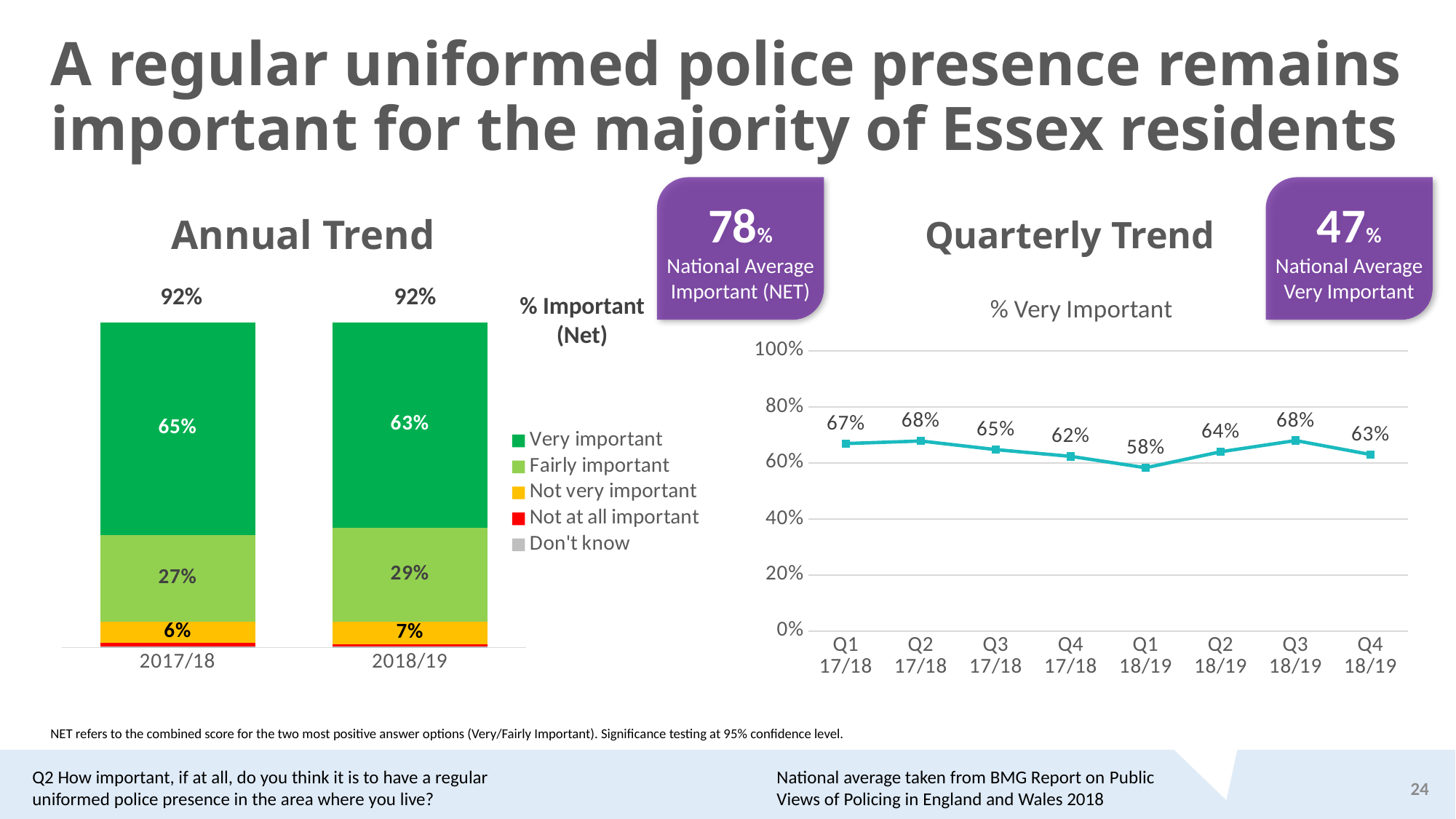
What kind of chart is the Quarterly Trend chart? Line chart In the Annual Trend chart, what is the difference between the Very important values for 2017/18 and 2018/19? 2% In the Annual Trend chart, what is the Fairly important value for 2017/18? 27% In the Annual Trend chart, which year has the larger Not very important value, 2017/18 or 2018/19? 2018/19 In the Quarterly Trend chart, what is the difference between the Q3 18/19 and Q4 18/19 values? 5% In the Quarterly Trend chart, what is the % Very Important value for Q1 18/19? 58% In the Quarterly Trend chart, which quarter has the lowest % Very Important value? Q1 18/19 How many quarters are plotted in the Quarterly Trend chart? 8 In the Annual Trend chart, what is the % Important (Net) figure shown above the 2018/19 bar? 92% How many series does the legend of the Annual Trend chart list? 5 What kind of chart is the Annual Trend chart? Stacked bar chart In the Annual Trend chart, what percentage of respondents said a regular uniformed police presence was very important in 2018/19? 63%